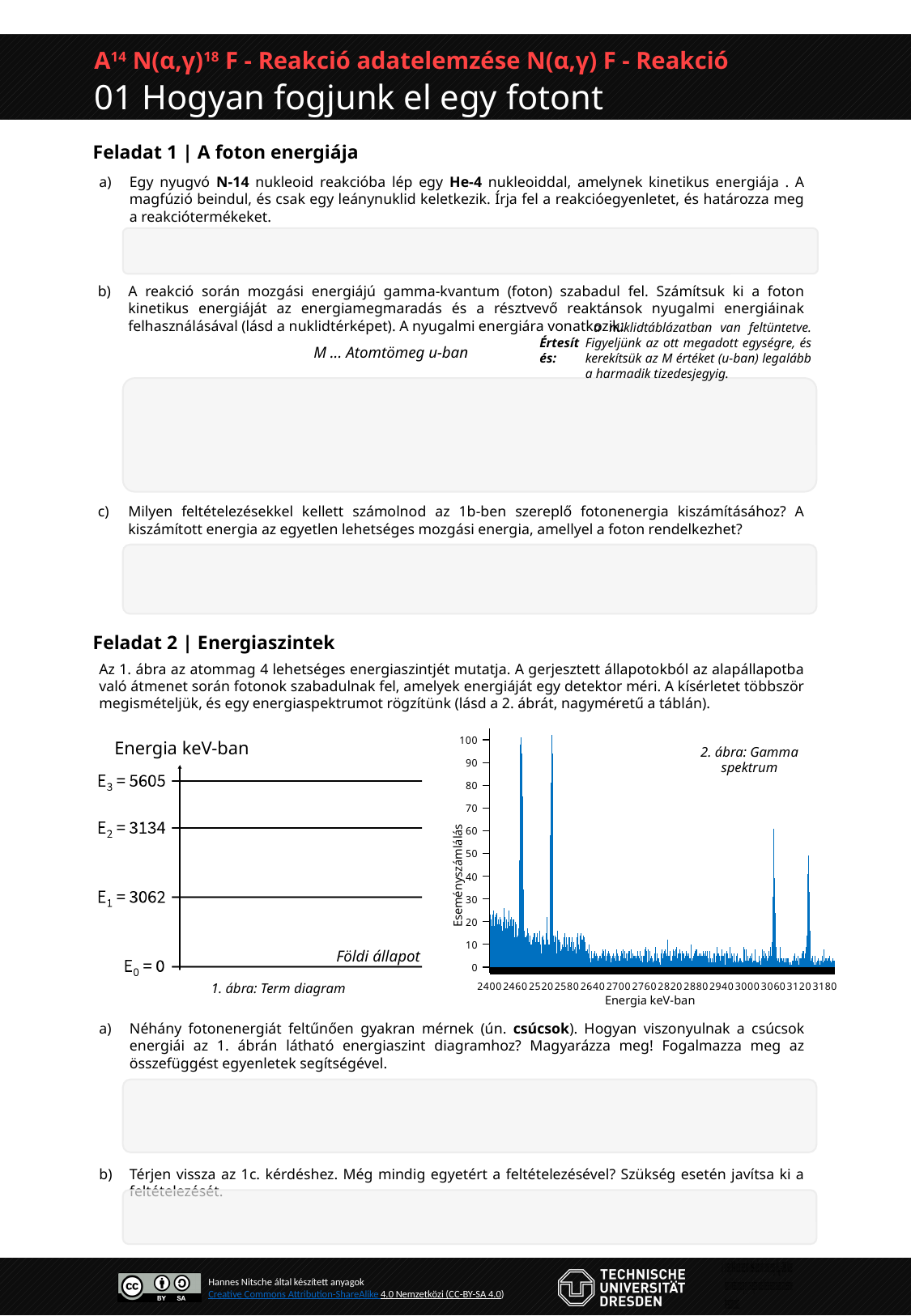
In the gamma spectrum chart (2. ábra), which is taller: the peak near 3060 keV or the peak near 3120 keV? the peak near 3060 keV In the gamma spectrum chart (2. ábra), is the peak near 3060 keV greater or less than 50 counts? greater In the gamma spectrum chart (2. ábra), what is the highest value shown on the y axis? 100 In the term diagram (1. ábra), what is the value of E3 in keV? 5605 In the term diagram (1. ábra), how many energy levels are shown? 4 In the gamma spectrum chart (2. ábra), which is taller: the peak near 2440 keV or the peak near 3060 keV? the peak near 2440 keV In the gamma spectrum chart (2. ábra), is the peak near 3120 keV greater or less than 70 counts? less In the term diagram (1. ábra), what is the difference between E2 and E1 in keV? 72 In the gamma spectrum chart (2. ábra), what is the title of the y axis? Eseményszámlálás In the term diagram (1. ábra), what is the value of E2 in keV? 3134 In the gamma spectrum chart (2. ábra), what is the title of the x axis? Energia keV-ban In the gamma spectrum chart (2. ábra), what is the lowest energy value labelled on the x axis? 2400